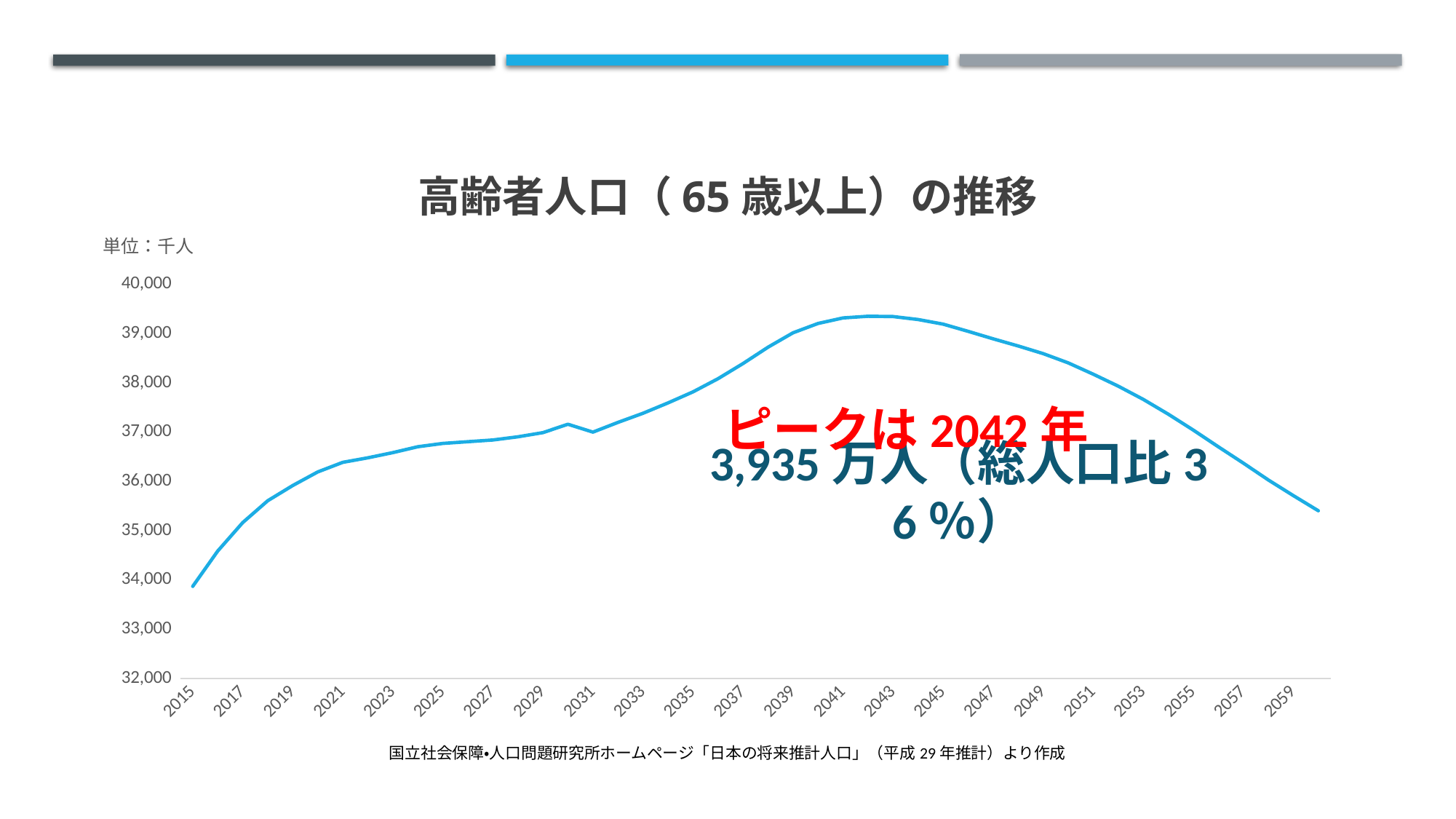
Is the value for 2059 greater or less than 35,000? greater Is the value for 2057 greater or less than 37,000? less Is the value for 2041 greater or less than 39,000? greater According to the annotation on the chart, in which year does the elderly population peak? 2042年 Which is larger, the value for 2015 or the value for 2059? 2059 According to the annotation on the chart, what is the peak elderly population? 3,935万人 Does the elderly population rise or fall between 2043 and 2059? fall What is the title of the chart? 高齢者人口（65歳以上）の推移 What kind of chart is shown on the slide? line chart Which year on the x axis has the lowest elderly population? 2015 What unit is stated for the values on the chart? 千人